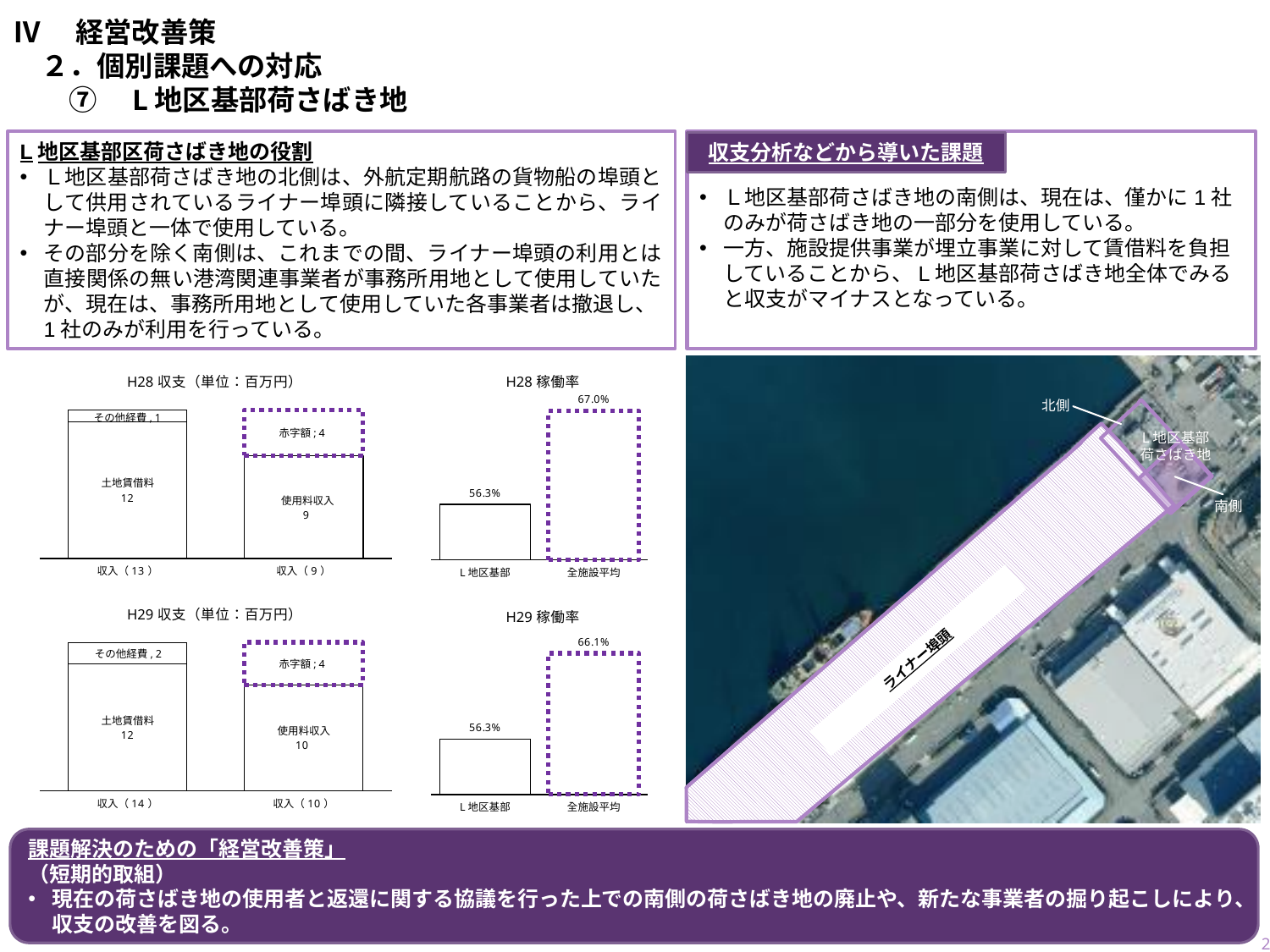
In the H29 稼働率 chart, which category is higher, L地区基部 or 全施設平均? 全施設平均 In the H29 収支 chart, what is the value of その他経費? 2 In the H28 収支 chart, what is the value of 土地賃借料? 12 In the H28 稼働率 chart, what is the value for L地区基部? 56.3% In the H29 収支 chart, what is the value of 赤字額? 4 How many categories are shown on the x axis of the H28 稼働率 chart? 2 In the H29 収支 chart, what is the total of the left stacked bar (土地賃借料 plus その他経費)? 14 In the H28 収支 chart, what is the value of 使用料収入? 9 What kind of chart is the H29 稼働率 chart? Bar chart In the H28 稼働率 chart, what is the difference between 全施設平均 and L地区基部? 10.7% In the H29 稼働率 chart, what is the value for 全施設平均? 66.1% In the H28 稼働率 chart, what is the value for 全施設平均? 67.0%